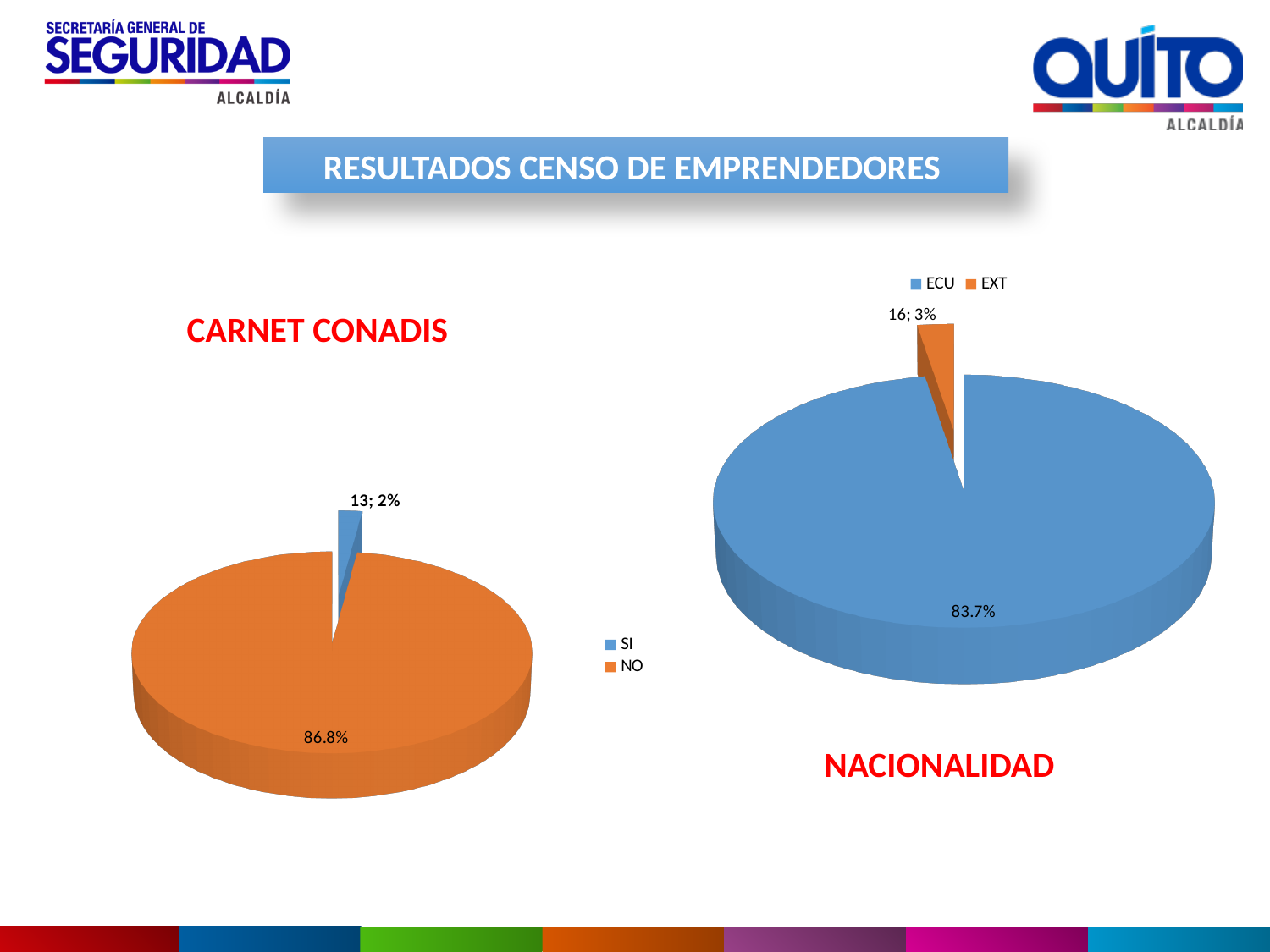
In the CARNET CONADIS chart, what label is shown on the SI slice? 13; 2% What type of chart is the CARNET CONADIS chart? pie chart How many slices does the NACIONALIDAD chart have? 2 In the NACIONALIDAD chart, what label is shown on the ECU slice? 83.7% What type of chart is the NACIONALIDAD chart? pie chart In the NACIONALIDAD chart, what label is shown on the EXT slice? 16; 3% In the CARNET CONADIS chart, which category has the largest slice? NO In the NACIONALIDAD chart, which category has the smallest slice? EXT In the NACIONALIDAD chart, what colour is the ECU slice? blue In the NACIONALIDAD chart, which slice is larger, ECU or EXT? ECU In the CARNET CONADIS chart, what label is shown on the NO slice? 86.8% How many categories does the legend of the CARNET CONADIS chart list? 2